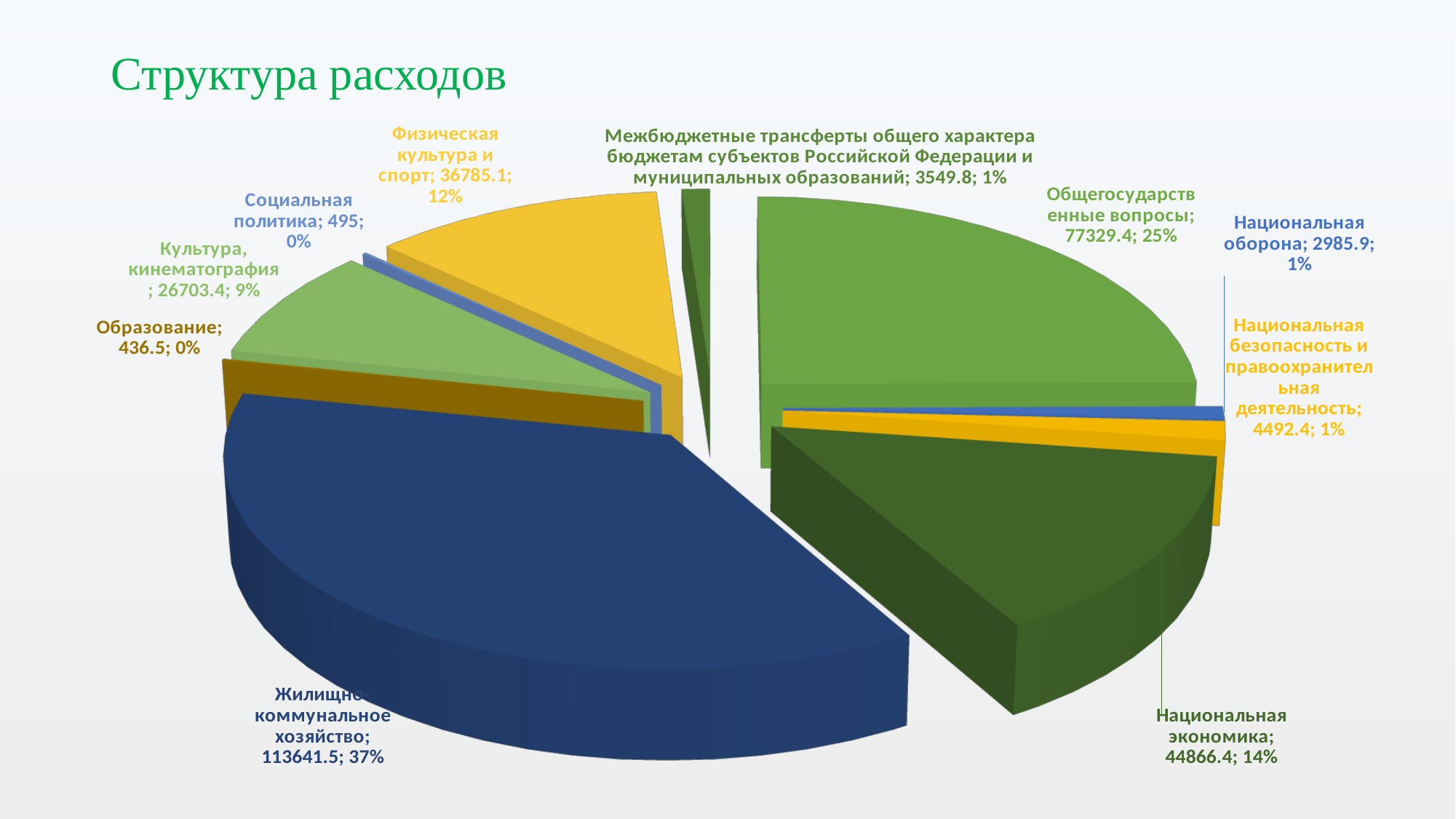
What is the difference between the values for Жилищно-коммунальное хозяйство and Общегосударственные вопросы? 36312.1 Which is larger, the value for Национальная оборона or the value for Национальная безопасность и правоохранительная деятельность? Национальная безопасность и правоохранительная деятельность What is the title of the chart? Структура расходов Which category has the largest value? Жилищно-коммунальное хозяйство What share of the pie does Культура, кинематография represent? 9% How many categories (slices) does the pie chart have? 10 What share of the pie does Физическая культура и спорт represent? 12% What is the value for Жилищно-коммунальное хозяйство? 113641.5 Which category has the smallest value? Образование What is the value for Общегосударственные вопросы? 77329.4 What kind of chart is shown on the slide? Pie chart What is the value for Национальная экономика? 44866.4